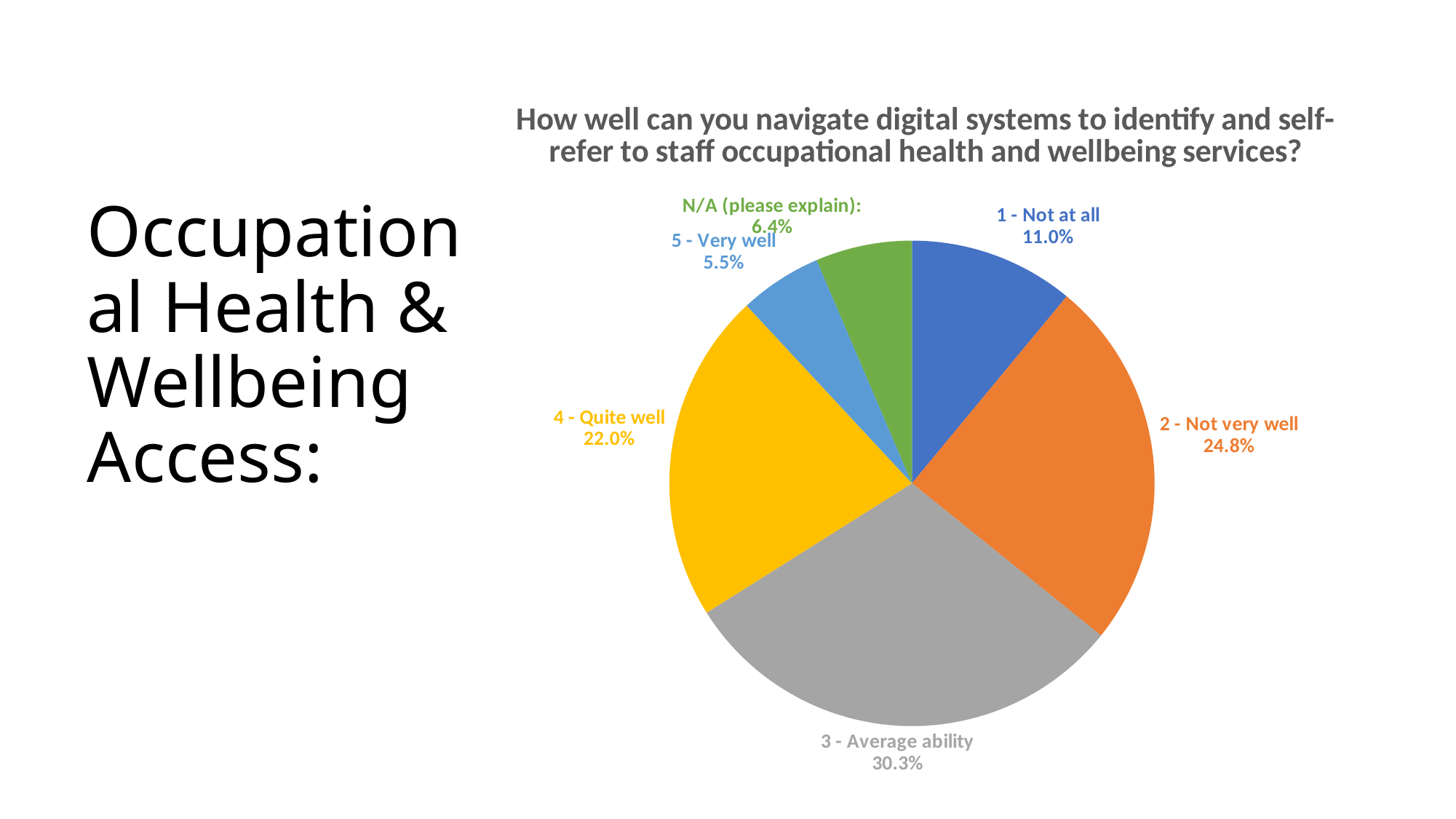
What percentage of respondents answered 'N/A (please explain):'? 6.4% What is the combined share of '1 - Not at all' and '2 - Not very well'? 35.8% Which response category has the smallest share of the pie? 5 - Very well What colour is the slice for '4 - Quite well'? Yellow What percentage of respondents answered '3 - Average ability'? 30.3% What percentage of respondents answered '1 - Not at all'? 11.0% What percentage of respondents answered '5 - Very well'? 5.5% What is the difference in percentage points between '2 - Not very well' and '4 - Quite well'? 2.8 Which is larger: the share for '1 - Not at all' or the share for '4 - Quite well'? 4 - Quite well How many categories are shown in the pie chart? 6 What type of chart is shown on the slide? Pie chart Which response category has the largest share of the pie? 3 - Average ability